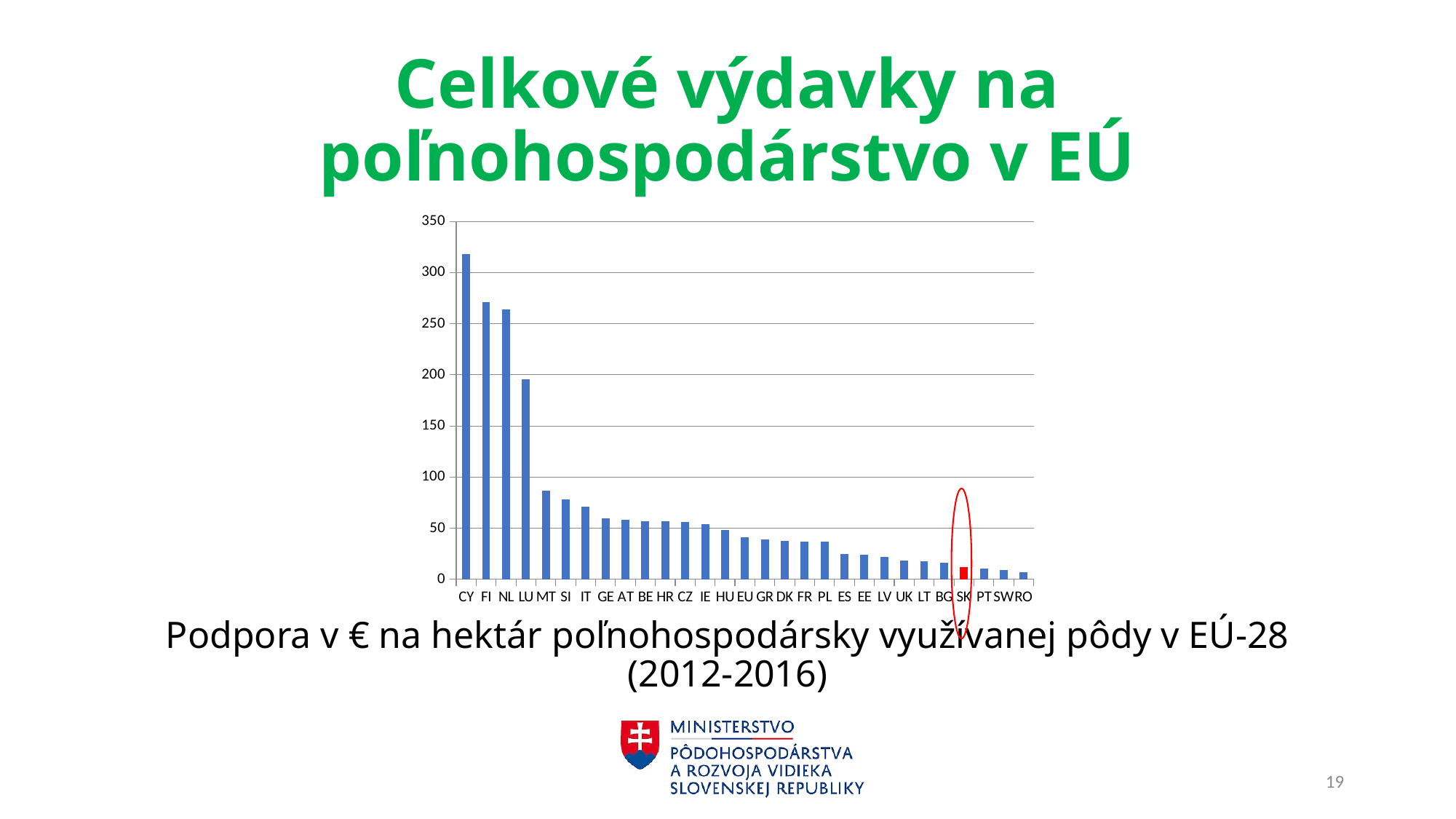
Which category has the lowest bar? RO Is the value for FI greater or less than 250? greater Which has the larger value, NL or LU? NL What kind of chart is shown on the slide? bar chart Is the value for MT greater or less than 100? less Which category has the highest bar? CY Which has the larger value, SK or PL? PL Which category's bar is coloured red and circled? SK Is the value for CY greater or less than 300? greater Do the values rise or fall from left to right along the x axis? fall